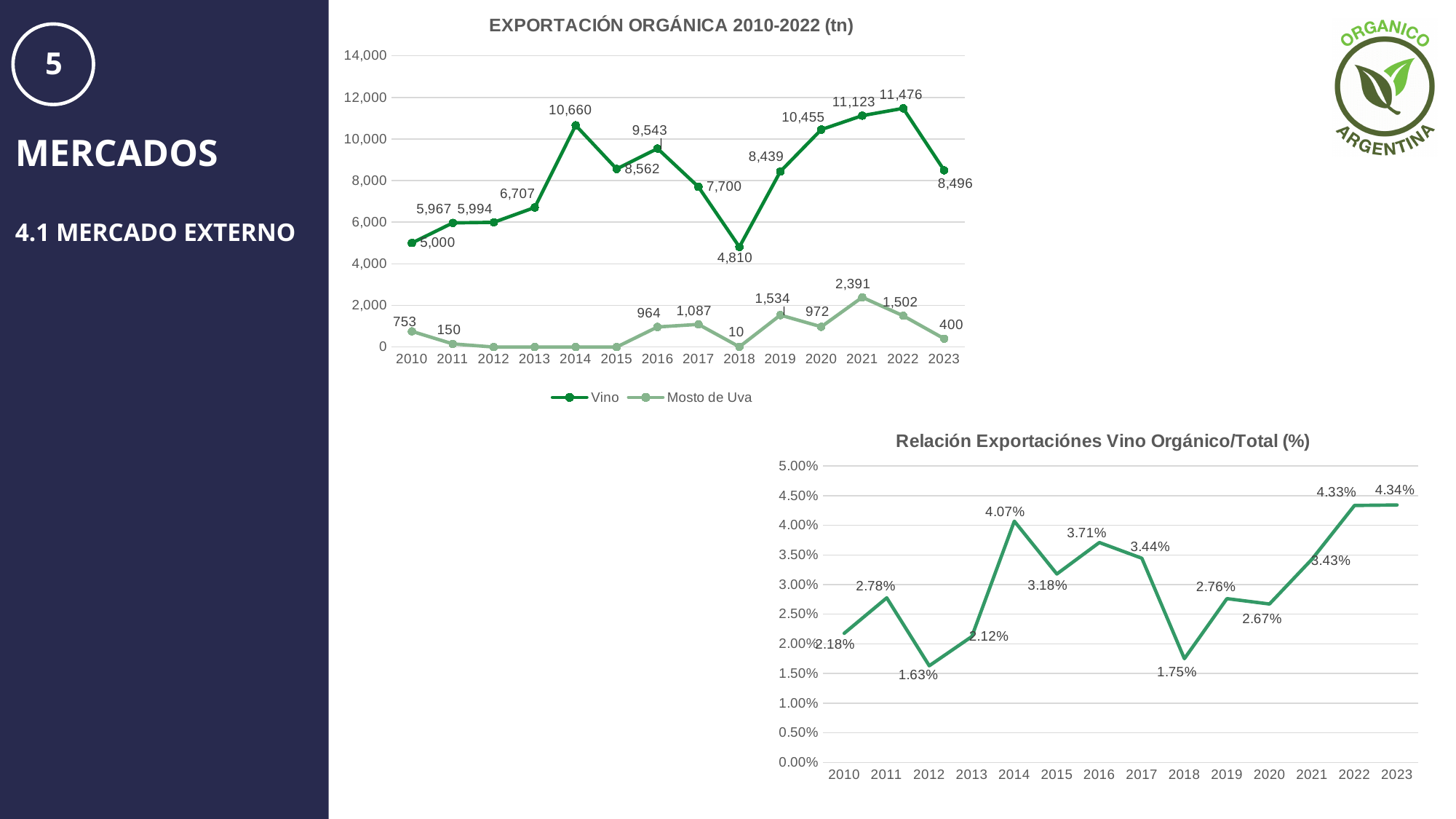
In the chart titled 'Relación Exportaciónes Vino Orgánico/Total (%)', do the values rise or fall from 2020 to 2023? Rise In the chart titled 'EXPORTACIÓN ORGÁNICA 2010-2022 (tn)', what is the Mosto de Uva value for 2021? 2,391 In the chart titled 'EXPORTACIÓN ORGÁNICA 2010-2022 (tn)', how many series does the legend list? 2 In the chart titled 'EXPORTACIÓN ORGÁNICA 2010-2022 (tn)', in which year is the Vino series highest? 2022 In the chart titled 'Relación Exportaciónes Vino Orgánico/Total (%)', what is the value for 2014? 4.07% In the chart titled 'EXPORTACIÓN ORGÁNICA 2010-2022 (tn)', what is the Vino value for 2014? 10,660 In the chart titled 'EXPORTACIÓN ORGÁNICA 2010-2022 (tn)', what is the difference between the Vino values for 2022 and 2023? 2,980 In the chart titled 'Relación Exportaciónes Vino Orgánico/Total (%)', how many years are plotted on the x axis? 14 In the chart titled 'Relación Exportaciónes Vino Orgánico/Total (%)', which year has the lowest value? 2012 In the chart titled 'EXPORTACIÓN ORGÁNICA 2010-2022 (tn)', in which year is the Vino series lowest? 2018 In the chart titled 'EXPORTACIÓN ORGÁNICA 2010-2022 (tn)', which year has the larger Mosto de Uva value, 2017 or 2020? 2017 In the chart titled 'EXPORTACIÓN ORGÁNICA 2010-2022 (tn)', what kind of chart is shown? Line chart